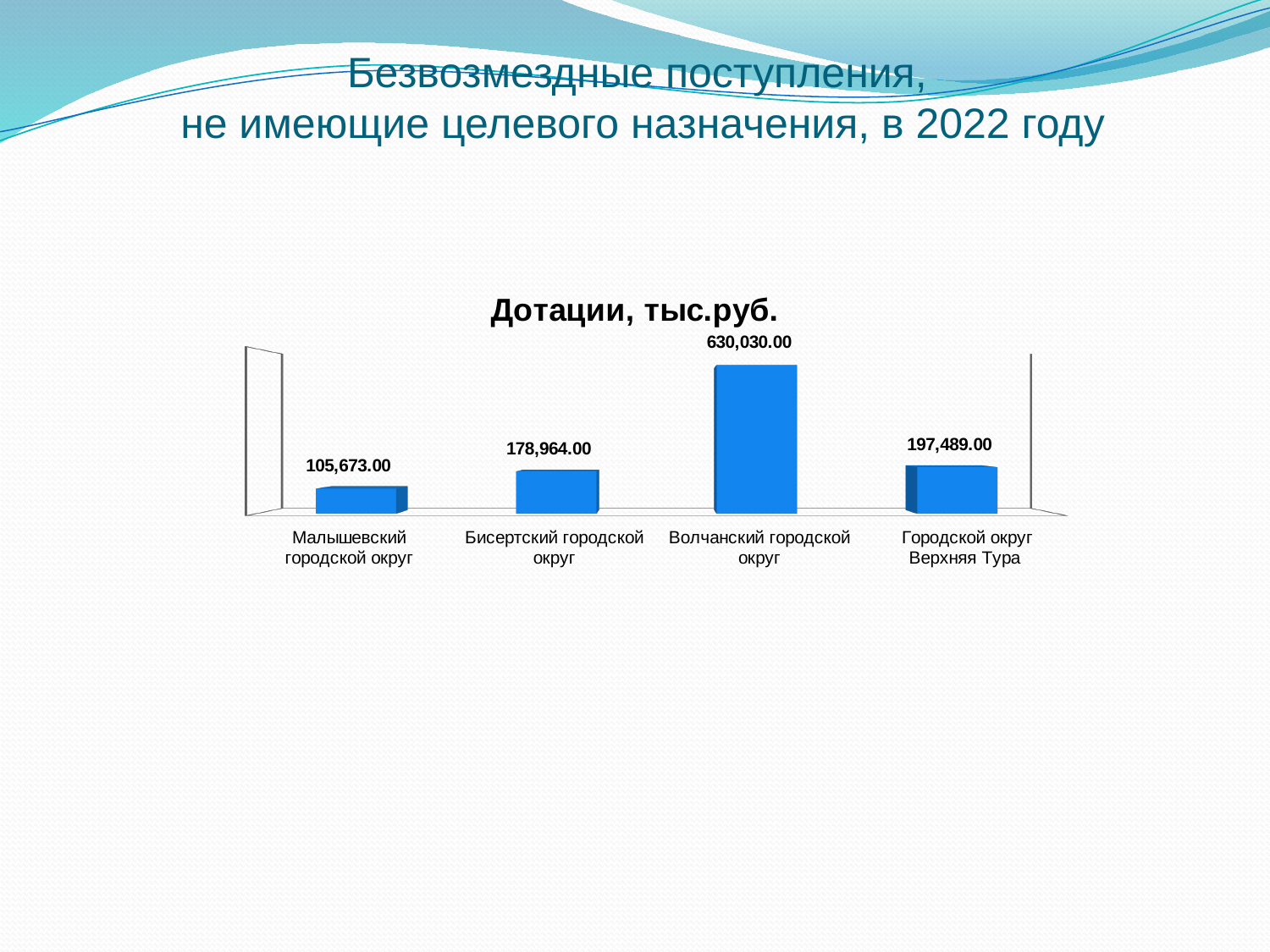
What is the value for Малышевский городской округ? 105,673.00 What is the difference between the values for Волчанский городской округ and Малышевский городской округ? 524,357.00 What is the title of the chart? Дотации, тыс.руб. Which is larger, the value for Бисертский городской округ or the value for Городской округ Верхняя Тура? Городской округ Верхняя Тура How many categories are shown in the chart? 4 Which category has the lowest value? Малышевский городской округ What is the value for Городской округ Верхняя Тура? 197,489.00 What is the value for Бисертский городской округ? 178,964.00 What is the value for Волчанский городской округ? 630,030.00 Which category has the highest value? Волчанский городской округ What is the difference between the values for Городской округ Верхняя Тура and Бисертский городской округ? 18,525.00 What kind of chart is shown on the slide? Bar chart